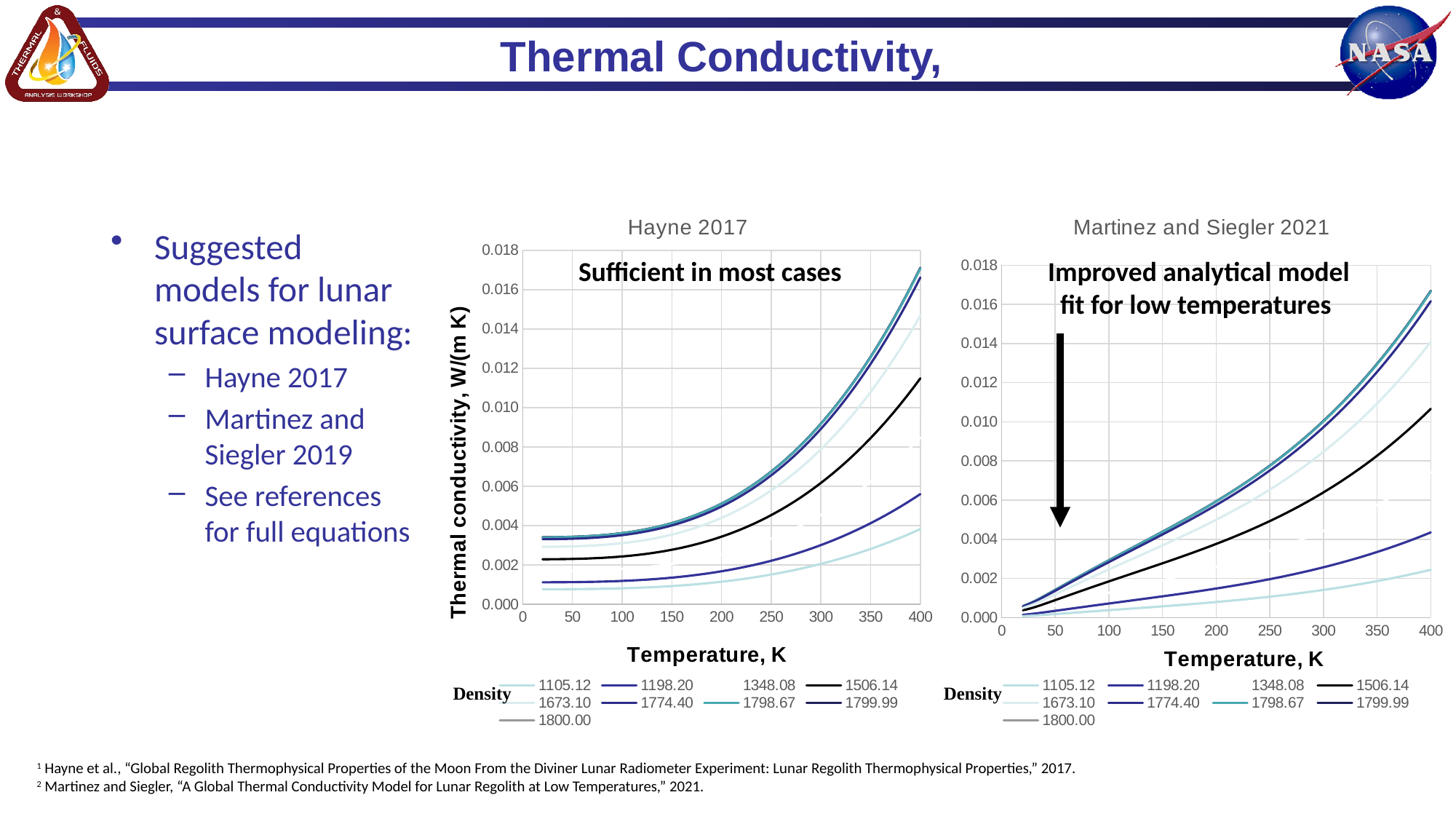
What is the title of the legend on the Martinez and Siegler 2021 chart? Density What is the y-axis label of the Hayne 2017 chart? Thermal conductivity, W/(m K) In the Hayne 2017 chart, is the value for density 1506.14 at 400 K greater or less than 0.010? greater What kind of chart is the Hayne 2017 chart? line chart What kind of chart is the Martinez and Siegler 2021 chart? line chart In the Martinez and Siegler 2021 chart, is the value for density 1506.14 at 400 K greater or less than 0.008? greater In the Martinez and Siegler 2021 chart, do the thermal conductivity values rise or fall as temperature increases? rise How many series does the legend of the Hayne 2017 chart list? 9 In the Hayne 2017 chart, is the value for density 1506.14 at 100 K greater or less than 0.004? less In the Hayne 2017 chart, do the thermal conductivity values rise or fall as temperature increases? rise How many series does the legend of the Martinez and Siegler 2021 chart list? 9